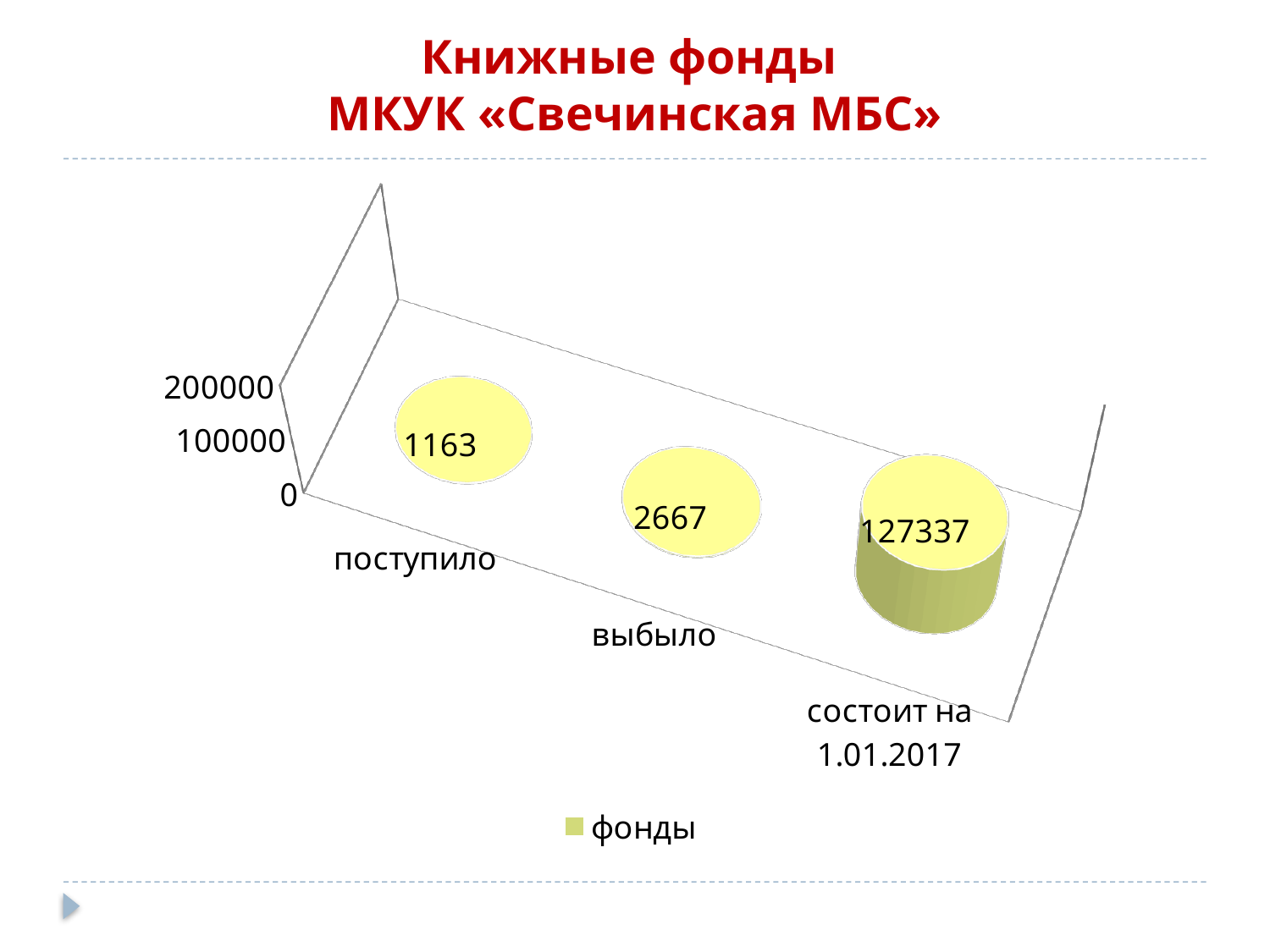
What is the name of the series in the legend? фонды Which category has the lowest value? поступило Which is larger, the value for выбыло or the value for поступило? выбыло What kind of chart is shown on the slide? bar chart Is the value for состоит на 1.01.2017 greater or less than 100000? greater What is the difference between the values for выбыло and поступило? 1504 What is the value for состоит на 1.01.2017? 127337 How many series does the legend list? 1 How many categories are shown on the chart? 3 What is the value for выбыло? 2667 What is the value for поступило? 1163 Which category has the highest value? состоит на 1.01.2017